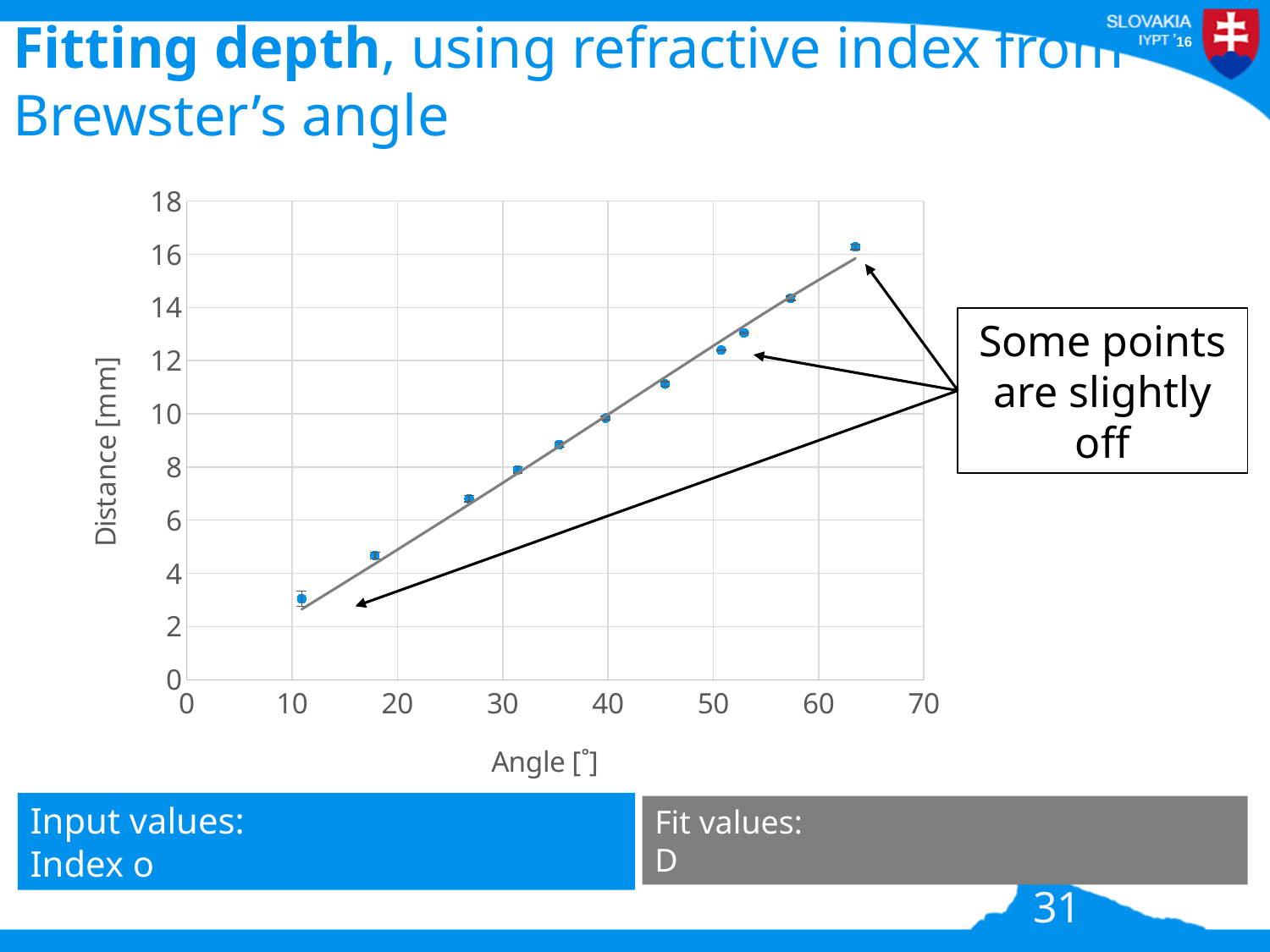
What is the label of the x axis? Angle [°] What is the maximum value shown on the y axis? 18 What is the label of the y axis? Distance [mm] Is the distance value for the data point at about 45° greater or less than 10? greater Is the distance value for the data point at about 35° greater or less than 10? less What kind of chart is shown on the slide? scatter chart Is the distance value for the leftmost data point (about 11°) greater or less than 4? less Do the plotted distance values rise or fall as the angle increases along the x axis? rise Which data point has the highest distance value: the one at about 63° or the one at about 11°? the one at about 63°